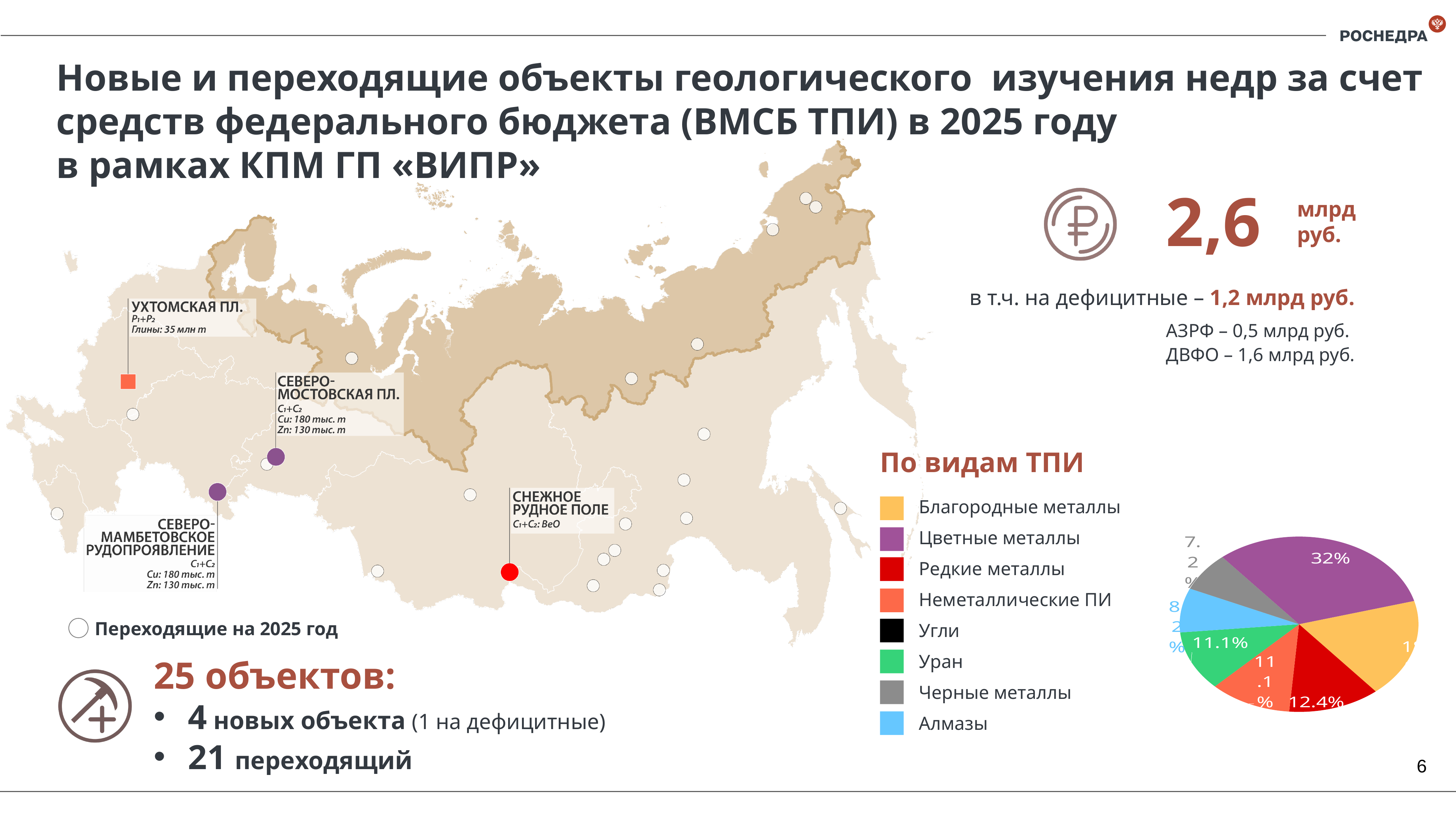
In the «По видам ТПИ» pie chart, what share is shown for Неметаллические ПИ? 11.1% In the «По видам ТПИ» pie chart, which slice is larger: Редкие металлы or Уран? Редкие металлы How many entries does the legend of the «По видам ТПИ» pie chart list? 8 In the «По видам ТПИ» pie chart, what share is shown for Черные металлы? 7.2% In the «По видам ТПИ» pie chart, by how many percentage points does the Цветные металлы share exceed the Редкие металлы share? 19.6 percentage points In the «По видам ТПИ» pie chart, what share is shown for Редкие металлы? 12.4% In the «По видам ТПИ» pie chart, what share is shown for Цветные металлы? 32% In the «По видам ТПИ» pie chart, what share is shown for Уран? 11.1% What kind of chart is shown under the heading «По видам ТПИ»? pie chart Which category has the largest slice in the «По видам ТПИ» pie chart? Цветные металлы What colour represents Уран in the «По видам ТПИ» pie chart legend? green In the «По видам ТПИ» pie chart, which slice is larger: Цветные металлы or Редкие металлы? Цветные металлы